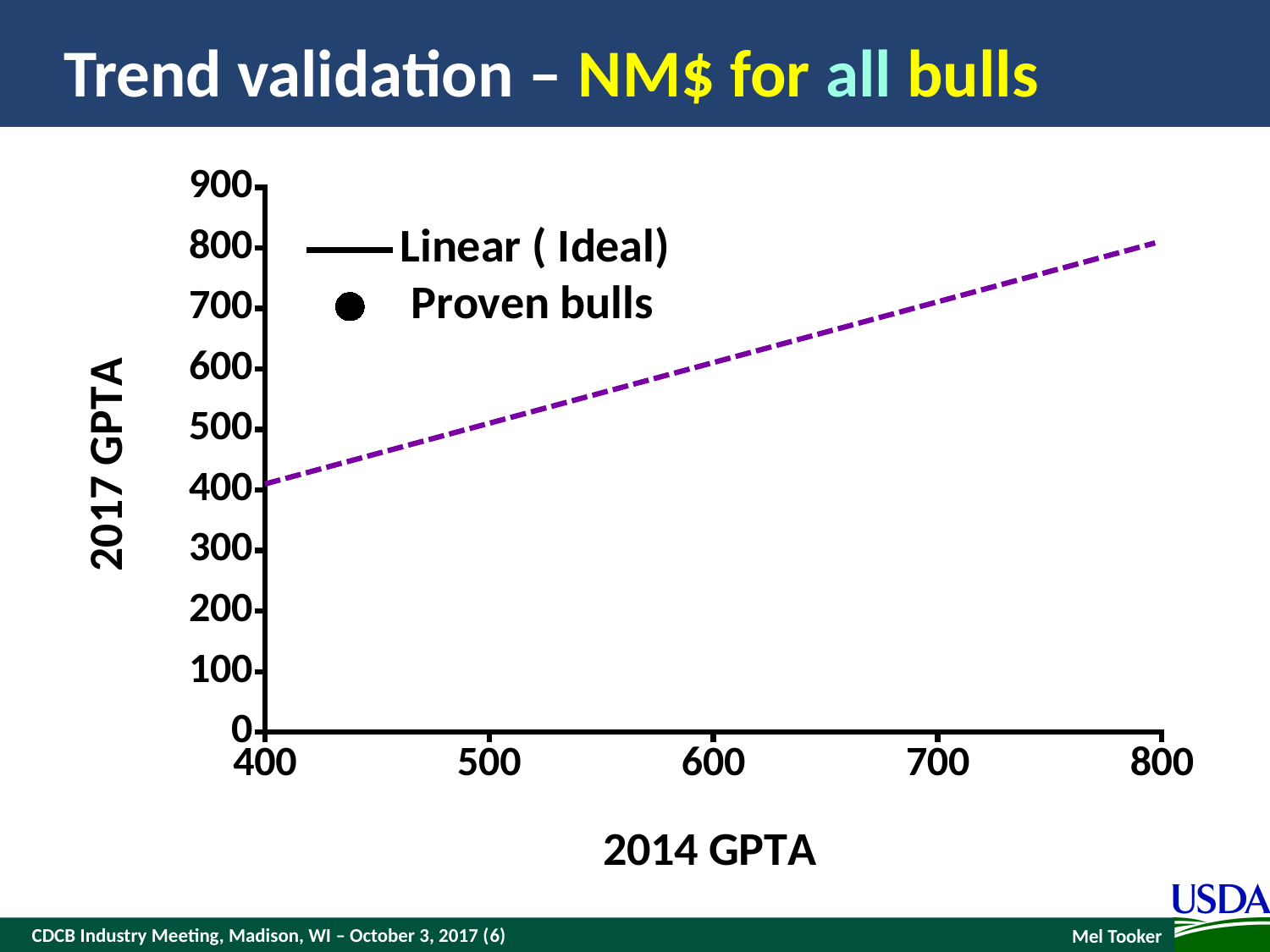
Is the value of the Linear (Ideal) line at a 2014 GPTA of 600 greater or less than 500? greater Is the value of the Linear (Ideal) line at a 2014 GPTA of 400 greater or less than 500? less What are the two entries listed in the legend? Linear ( Ideal) and Proven bulls Does the dashed Linear (Ideal) line rise or fall as 2014 GPTA increases? rises What is the label of the x axis? 2014 GPTA How many series does the legend list? 2 How many labelled tick marks are on the x axis? 5 Is the value of the Linear (Ideal) line at a 2014 GPTA of 800 greater or less than 700? greater What kind of chart is shown on the slide? line chart